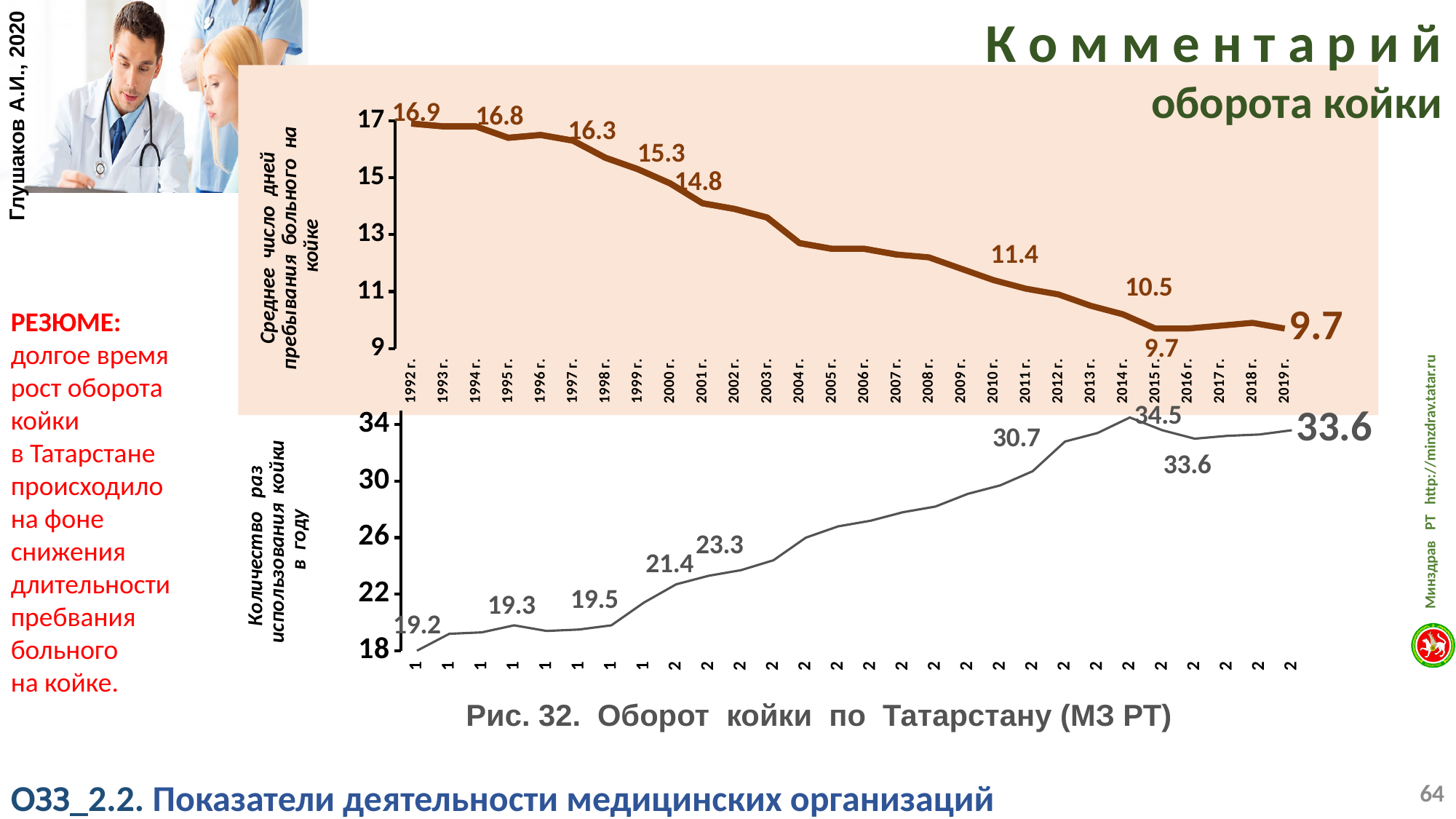
In the top chart (Среднее число дней пребывания больного на койке), is the value for 2008 г. greater or less than 13? less In the top chart (Среднее число дней пребывания больного на койке), what is the difference between the value for 1992 г. and the value for 2019 г.? 7.2 How many years are shown on the x axis of the top chart (Среднее число дней пребывания больного на койке)? 28 In the top chart (Среднее число дней пребывания больного на койке), what is the value for 1992 г.? 16.9 In the bottom chart (Количество раз использования койки в году), do the values rise or fall from the first point to the last point? rise What kind of chart is used in the top chart (Среднее число дней пребывания больного на койке)? line chart In the top chart (Среднее число дней пребывания больного на койке), do the values rise or fall from 1992 г. to 2019 г.? fall In the bottom chart (Количество раз использования койки в году), what is the highest labelled value? 34.5 In the top chart (Среднее число дней пребывания больного на койке), which year has the highest value? 1992 г. In the top chart (Среднее число дней пребывания больного на койке), what is the value for 2019 г.? 9.7 What is the figure caption printed below the charts? Рис. 32. Оборот койки по Татарстану (МЗ РТ)